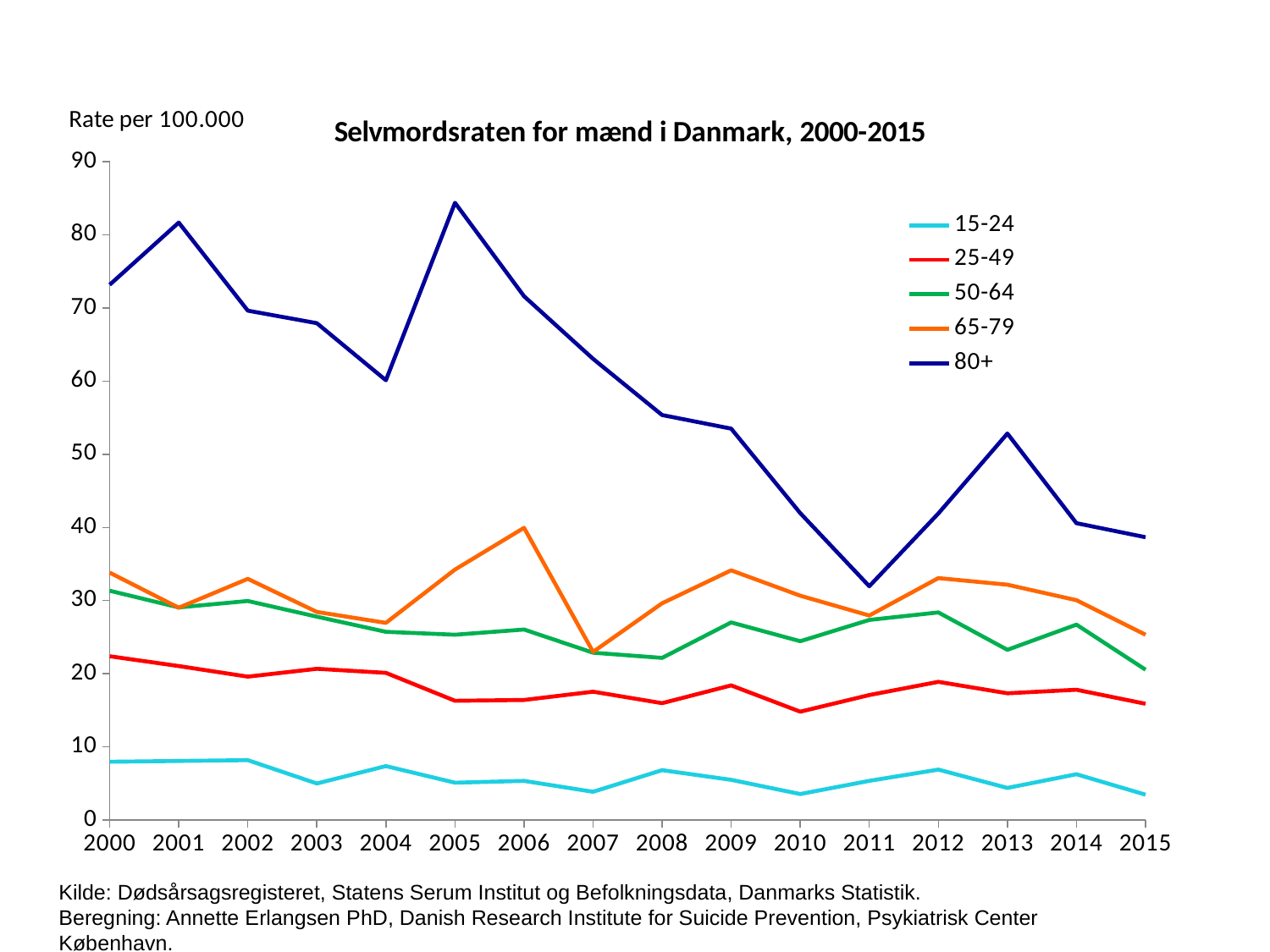
How many years are plotted along the x axis? 16 Is the value for the 80+ group in 2011 greater or less than 40? less In which year does the 80+ line reach its highest value? 2005 Is the value for the 80+ group in 2005 greater or less than 80? greater How many series does the legend list? 5 Does the 80+ line overall rise or fall from 2000 to 2015? fall In 2013, which is larger: the value for 50-64 or the value for 25-49? 50-64 Which age group has the highest suicide rate in 2000? 80+ Which age group has the lowest suicide rate in 2015? 15-24 What kind of chart is shown on the slide? line chart Is the value for the 65-79 group in 2006 greater or less than 30? greater What is the title of the chart? Selvmordsraten for mænd i Danmark, 2000-2015